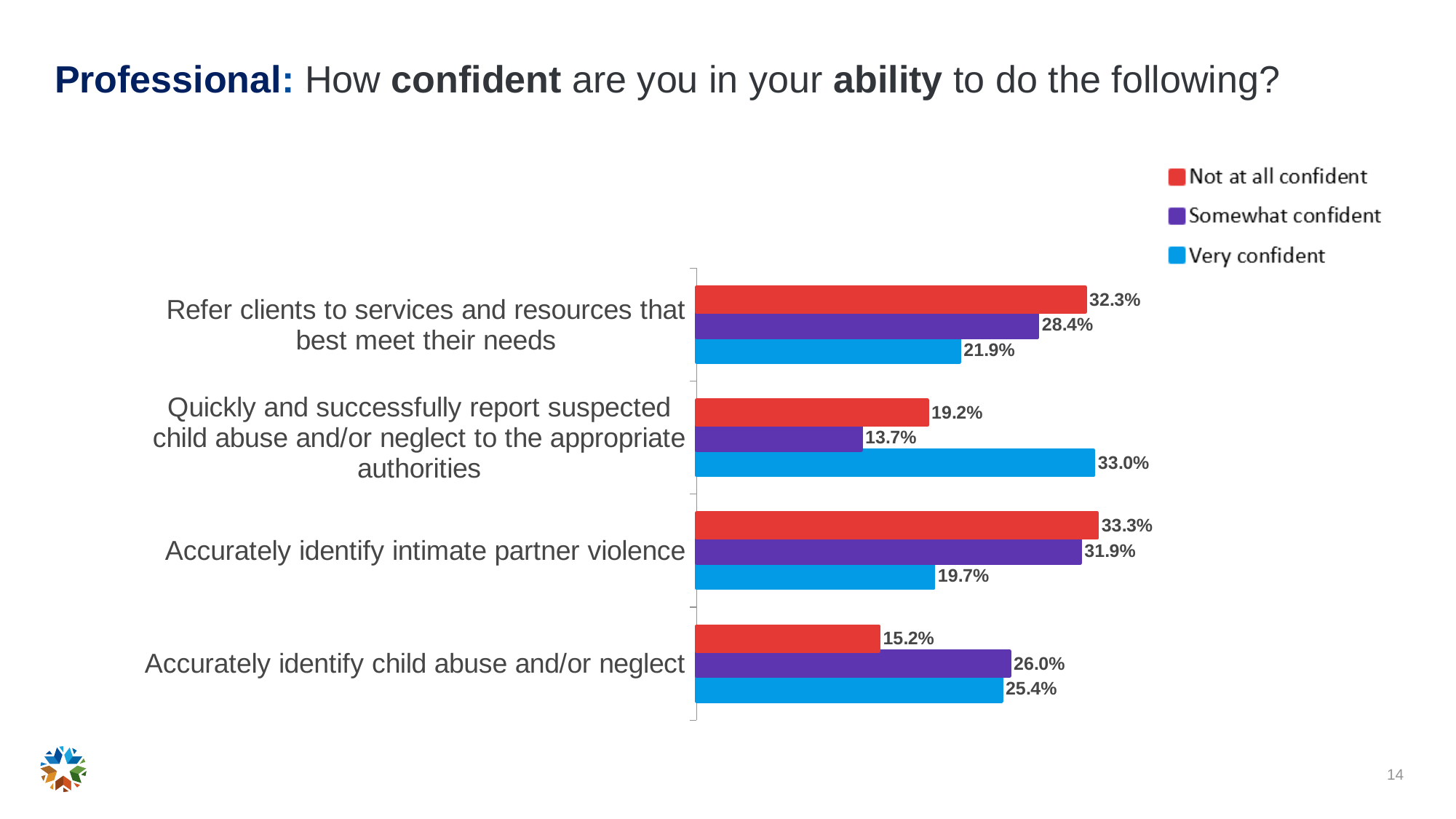
What kind of chart is shown on the slide? Bar chart What is the 'Very confident' value for refer clients to services and resources that best meet their needs? 21.9% Which category has the lowest 'Somewhat confident' value? Quickly and successfully report suspected child abuse and/or neglect to the appropriate authorities Which colour represents 'Very confident' in the chart? Blue For accurately identify child abuse and/or neglect, which is larger: the 'Somewhat confident' value or the 'Not at all confident' value? Somewhat confident Which category has the highest 'Not at all confident' value? Accurately identify intimate partner violence How many categories (abilities) are shown on the chart? 4 What percentage of professionals are 'Not at all confident' in their ability to accurately identify child abuse and/or neglect? 15.2% What percentage of professionals are 'Very confident' in their ability to quickly and successfully report suspected child abuse and/or neglect to the appropriate authorities? 33.0% What percentage of professionals are 'Somewhat confident' in their ability to refer clients to services and resources that best meet their needs? 28.4% What is the difference between the 'Not at all confident' and 'Very confident' values for accurately identify intimate partner violence? 13.6% How many series does the legend list? 3